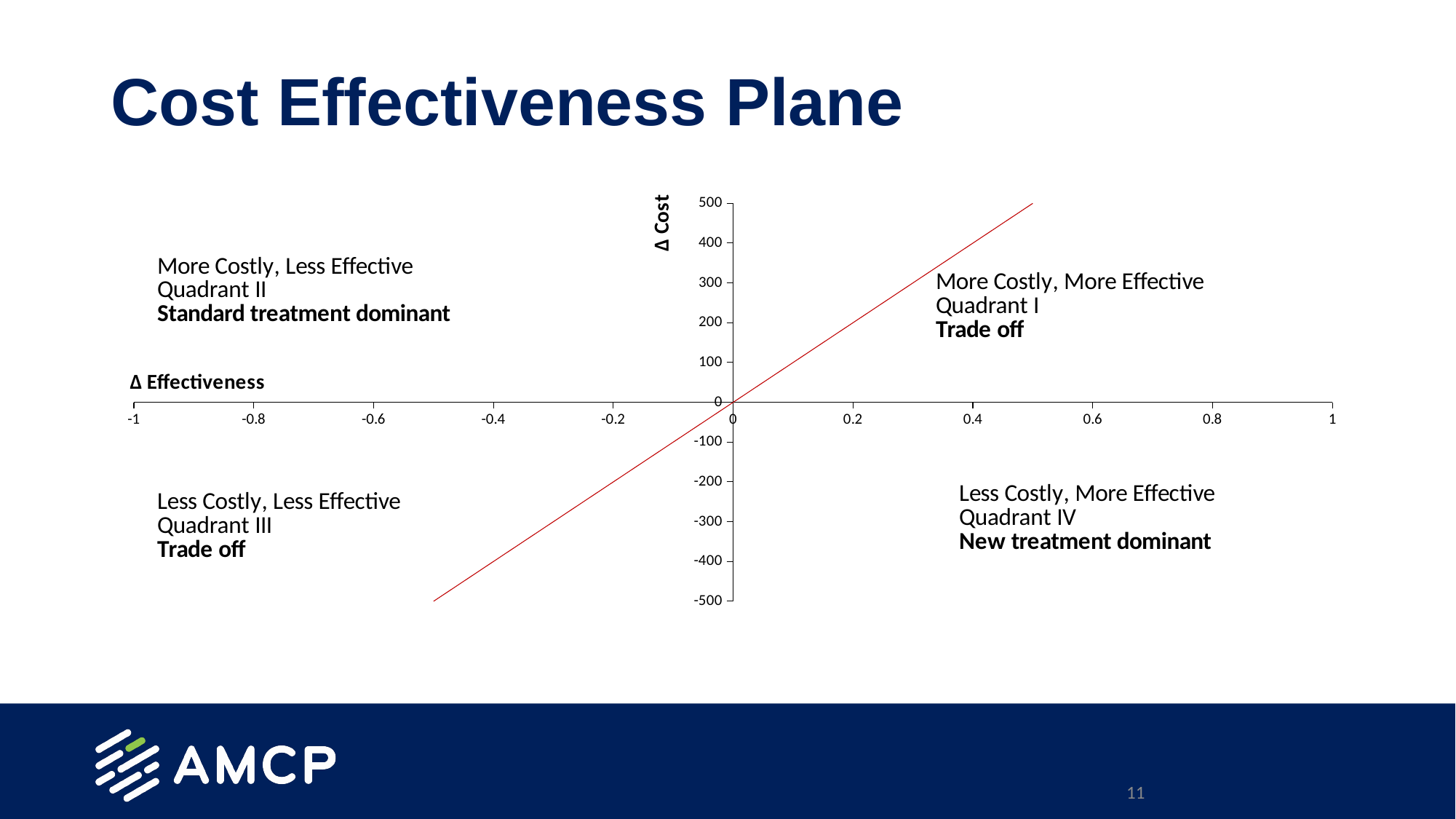
Does the red line rise or fall as Δ Effectiveness increases along the x axis? rises What kind of chart is shown on the slide? line chart What is the Δ Cost value of the red line where Δ Effectiveness equals 0? 0 What is the title of the slide containing the chart? Cost Effectiveness Plane What is the label of the vertical axis? Δ Cost What is the lowest value shown on the Δ Cost axis? -500 Is the Δ Cost value of the red line at Δ Effectiveness 0.4 larger than its value at Δ Effectiveness 0.2? yes Is the Δ Cost value of the red line at Δ Effectiveness 0.4 greater or less than 300? greater What is the highest value shown on the Δ Cost axis? 500 What is the lowest value shown on the Δ Effectiveness axis? -1 Is the Δ Cost value of the red line at Δ Effectiveness 0.2 greater or less than 300? less Is the Δ Cost value of the red line at Δ Effectiveness -0.4 greater or less than -300? less